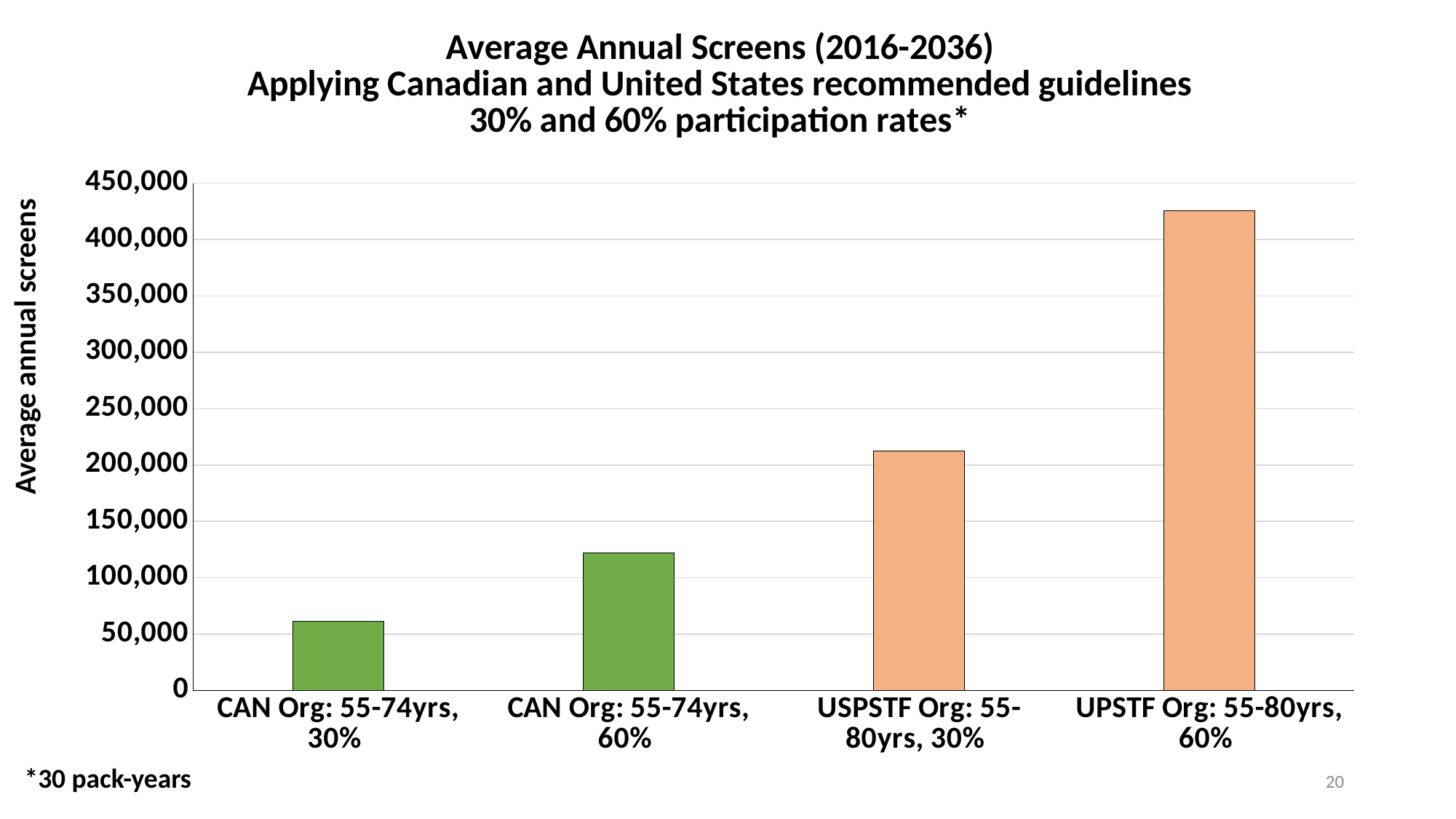
What is the label of the vertical axis? Average annual screens Do the bar values rise or fall from left to right across the categories? rise Which is larger: the value for CAN Org: 55-74yrs, 60% or the value for USPSTF Org: 55-80yrs, 30%? USPSTF Org: 55-80yrs, 30% How many bars (categories) are plotted in the chart? 4 Is the value for CAN Org: 55-74yrs, 30% greater or less than 100,000? less Is the value for CAN Org: 55-74yrs, 60% greater or less than 100,000? greater What colour are the bars for the CAN Org categories? green Which category has the lowest average annual screens? CAN Org: 55-74yrs, 30% Is the value for USPSTF Org: 55-80yrs, 30% greater or less than 200,000? greater What kind of chart is shown on the slide? bar chart Which category has the highest average annual screens? UPSTF Org: 55-80yrs, 60%